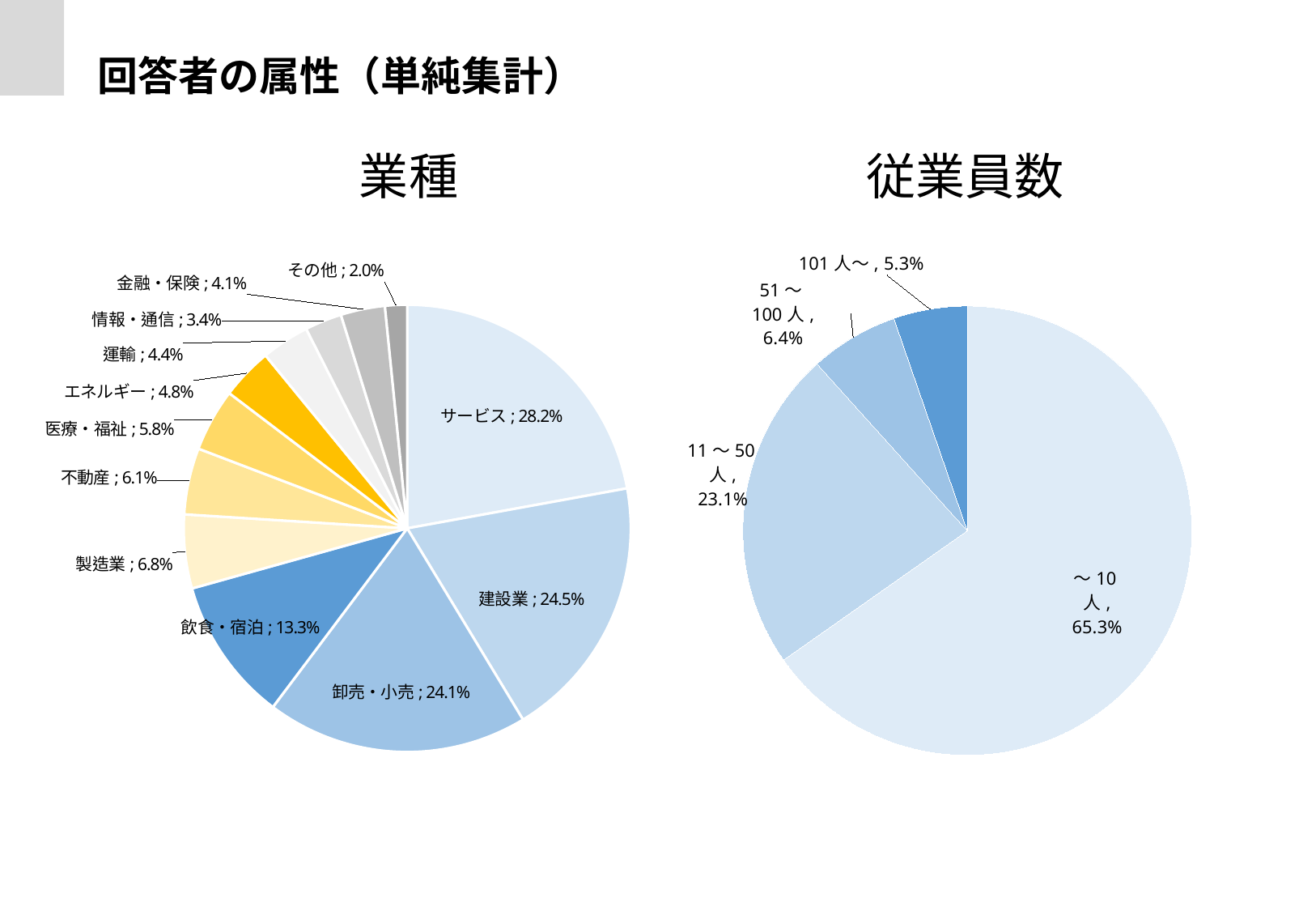
In the 従業員数 chart, what is the share for 11～50人? 23.1% In the 従業員数 chart, which category has the largest share? ～10人 In the 業種 chart, what is the difference in percentage points between 建設業 and 卸売・小売? 0.4 In the 従業員数 chart, what is the difference in percentage points between 51～100人 and 101人～? 1.1 In the 業種 chart, which category has the smallest share? その他 How many categories are shown in the 従業員数 chart? 4 In the 業種 chart, what is the share for サービス? 28.2% In the 業種 chart, what is the share for 飲食・宿泊? 13.3% In the 業種 chart, which category has the largest share? サービス How many categories are shown in the 業種 chart? 12 In the 業種 chart, which is larger, 製造業 or 不動産? 製造業 What kind of chart is the 業種 chart? pie chart